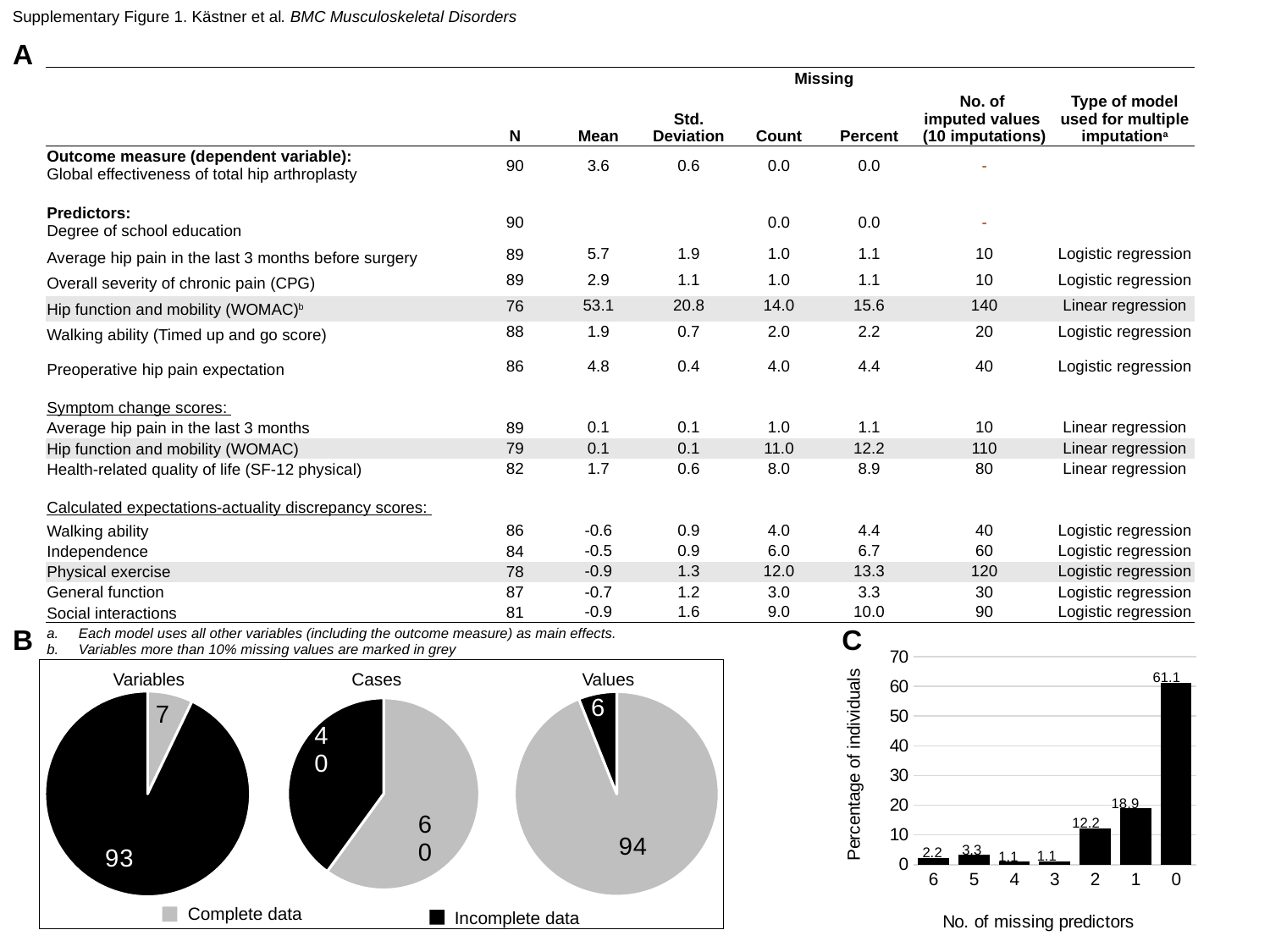
In the bar chart in panel C, how many categories are shown on the x axis? 7 In the 'Values' pie chart in panel B, which slice is larger: Complete data or Incomplete data? Complete data In the bar chart in panel C, which is larger: the percentage for 5 missing predictors or for 6 missing predictors? 5 missing predictors What kind of chart is shown in panel C? bar chart How many pie charts are shown in panel B? 3 In the bar chart in panel C, which number of missing predictors has the highest percentage of individuals? 0 In the bar chart in panel C, what is the difference between the percentages for 1 and 2 missing predictors? 6.7 In the 'Cases' pie chart in panel B, what is the value of the Complete data slice? 60 In the bar chart in panel C, what percentage of individuals have 2 missing predictors? 12.2 In the bar chart in panel C, is the value for 1 missing predictor greater or less than 10? greater In the 'Variables' pie chart in panel B, what is the value of the Incomplete data slice? 93 In the bar chart in panel C, what percentage of individuals have 0 missing predictors? 61.1